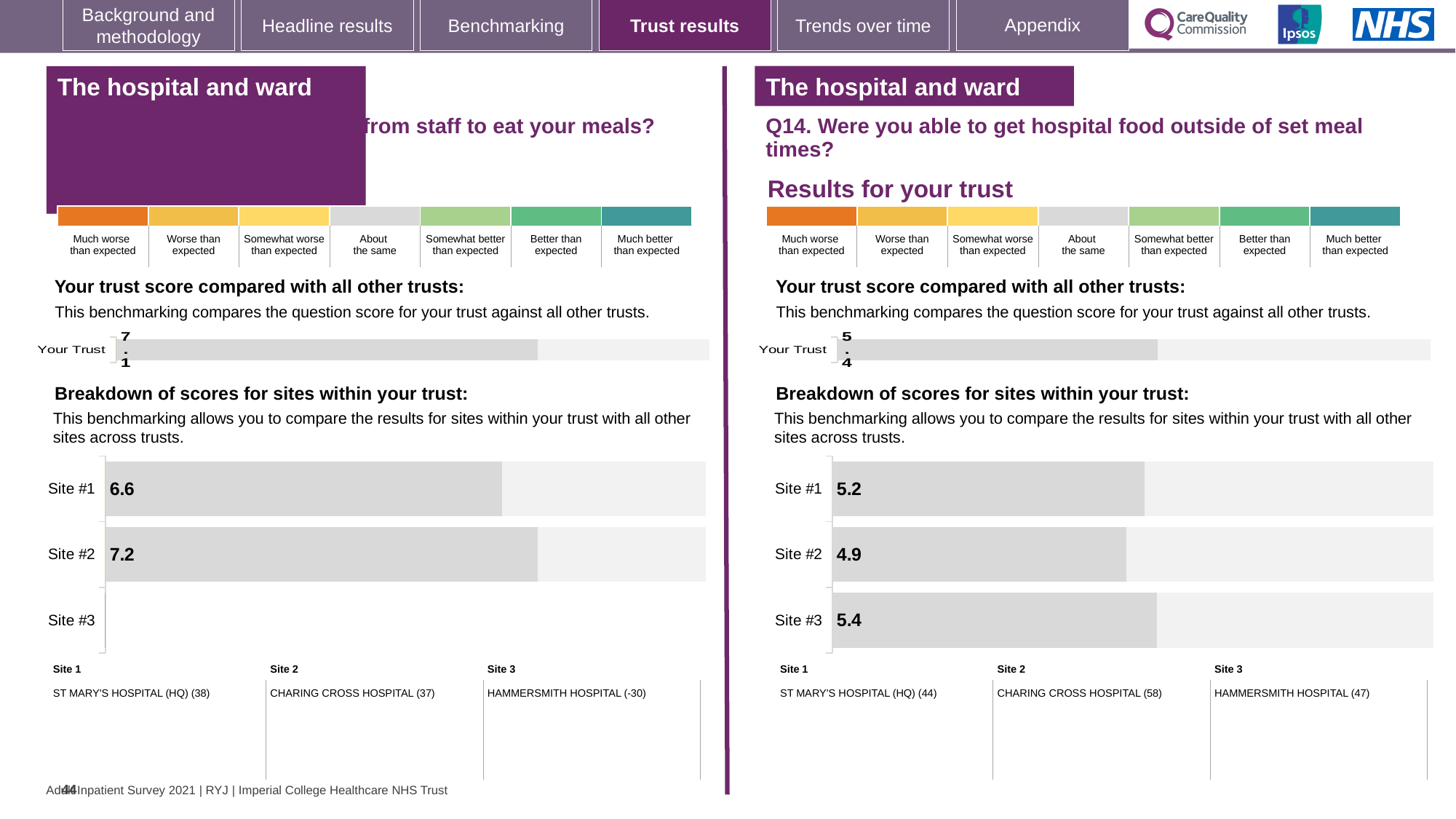
On the right-hand chart (Q14), which site has the highest score? Site #3 On the right-hand chart (Q14), what is the score for Site #1? 5.2 On the left-hand chart, what is the score for Site #2? 7.2 On the left-hand chart, what is the difference between the scores for Site #2 and Site #1? 0.6 On the right-hand chart (Q14), what is the score for Site #2? 4.9 How many sites are listed in the site breakdown chart on the right-hand side (Q14)? 3 On the right-hand chart (Q14), what is the score for Site #3? 5.4 What kind of chart is used to show the breakdown of scores for sites on the right-hand side of the slide? Bar chart On the right-hand chart (Q14), which site has the lowest score? Site #2 On the left-hand chart, which is larger, the score for Site #1 or Site #2? Site #2 On the right-hand chart (Q14), what is the difference between the scores for Site #3 and Site #2? 0.5 On the left-hand chart, what is the score for Site #1? 6.6